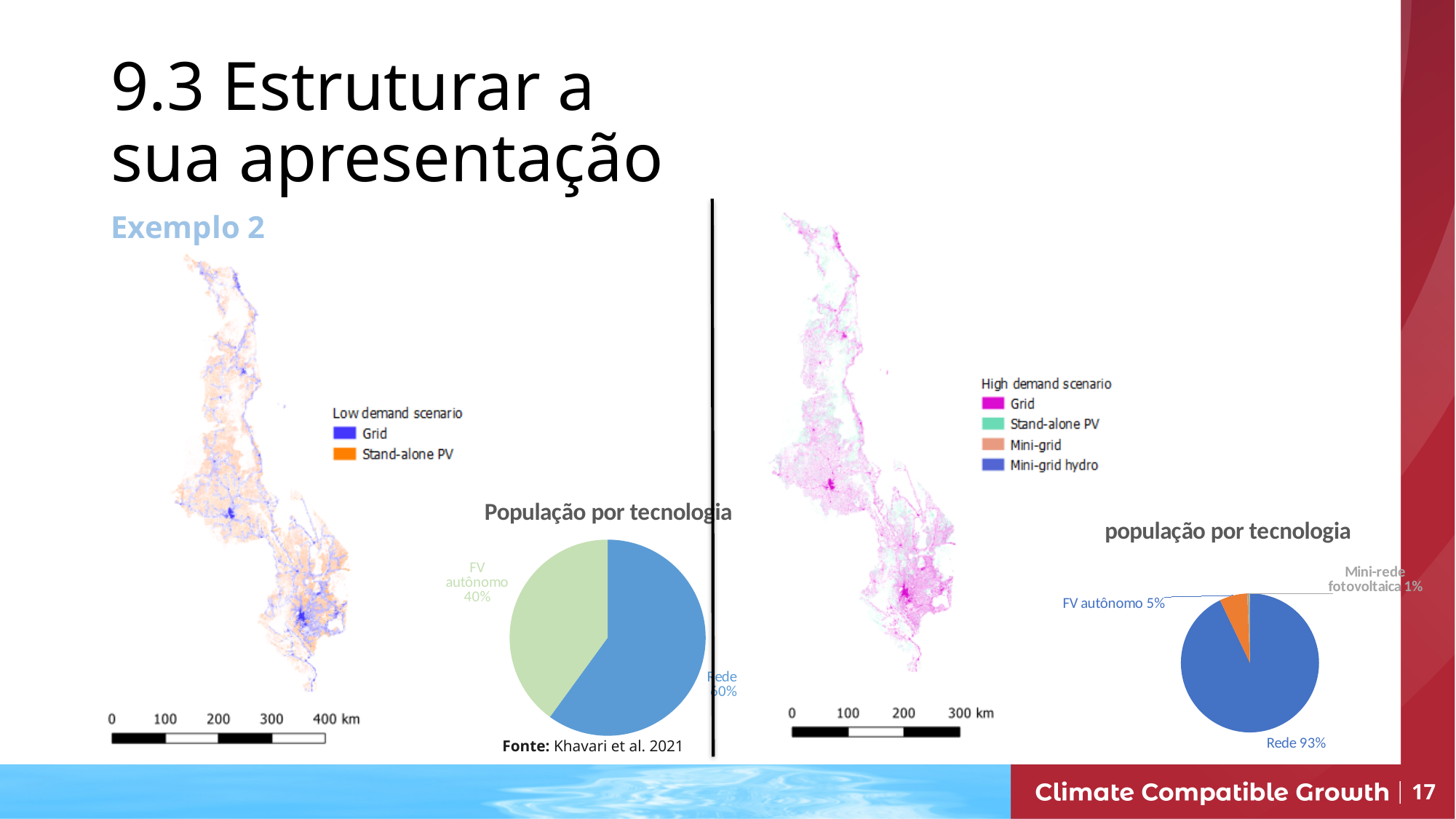
What kind of chart is the 'População por tecnologia' chart on the left side of the slide? pie chart In the right pie chart 'população por tecnologia', which category has the largest share? Rede How many slices does the left pie chart 'População por tecnologia' have? 2 In the right pie chart 'população por tecnologia', what share is labelled for Mini-rede fotovoltaica? 1% In the left pie chart 'População por tecnologia', which slice is larger, Rede or FV autônomo? Rede In the right pie chart 'população por tecnologia', what is the difference in percentage points between Rede and FV autônomo? 88 In the right pie chart 'população por tecnologia', what share is labelled for FV autônomo? 5% In the left pie chart 'População por tecnologia', what share is labelled for Rede? 60% In the left pie chart 'População por tecnologia', what share is labelled for FV autônomo? 40% In the right pie chart 'população por tecnologia', what share is labelled for Rede? 93%